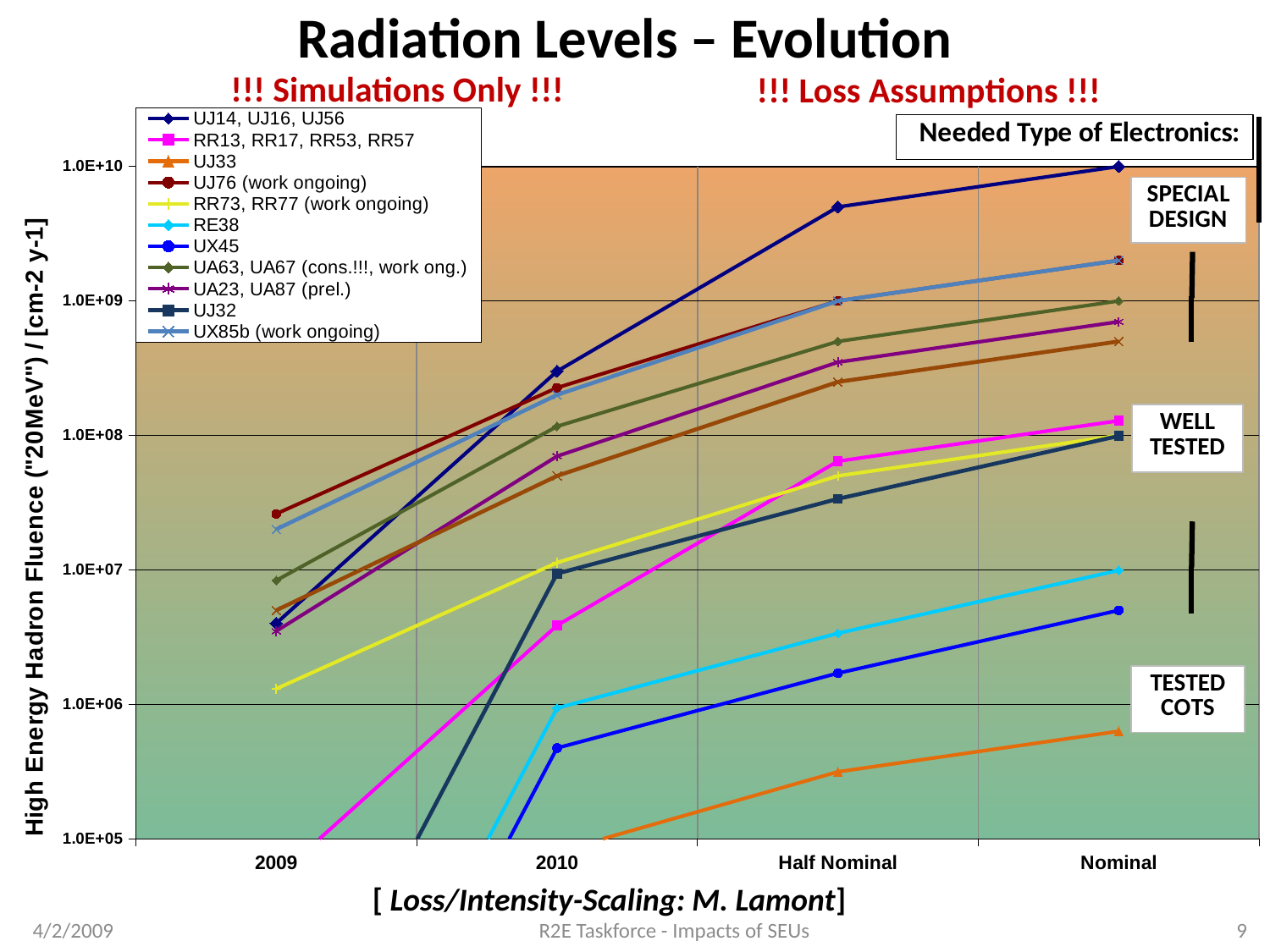
Is the value for UJ33 at Nominal greater or less than 1.0E+06? less Do the values for UJ14, UJ16, UJ56 rise or fall from 2009 to Nominal? rise Which series has the highest value at Nominal? UJ14, UJ16, UJ56 Is the value for UX45 at Nominal greater or less than 1.0E+07? less Which series has the lowest value at Half Nominal? UJ33 Is the value for UJ14, UJ16, UJ56 at Nominal greater or less than 1.0E+09? greater How many categories are shown on the x axis? 4 At Half Nominal, which is larger: the value for RE38 or the value for UX45? RE38 How many series does the chart legend list? 11 What is the title of the chart on the slide? Radiation Levels – Evolution What kind of chart is shown on the slide? line chart